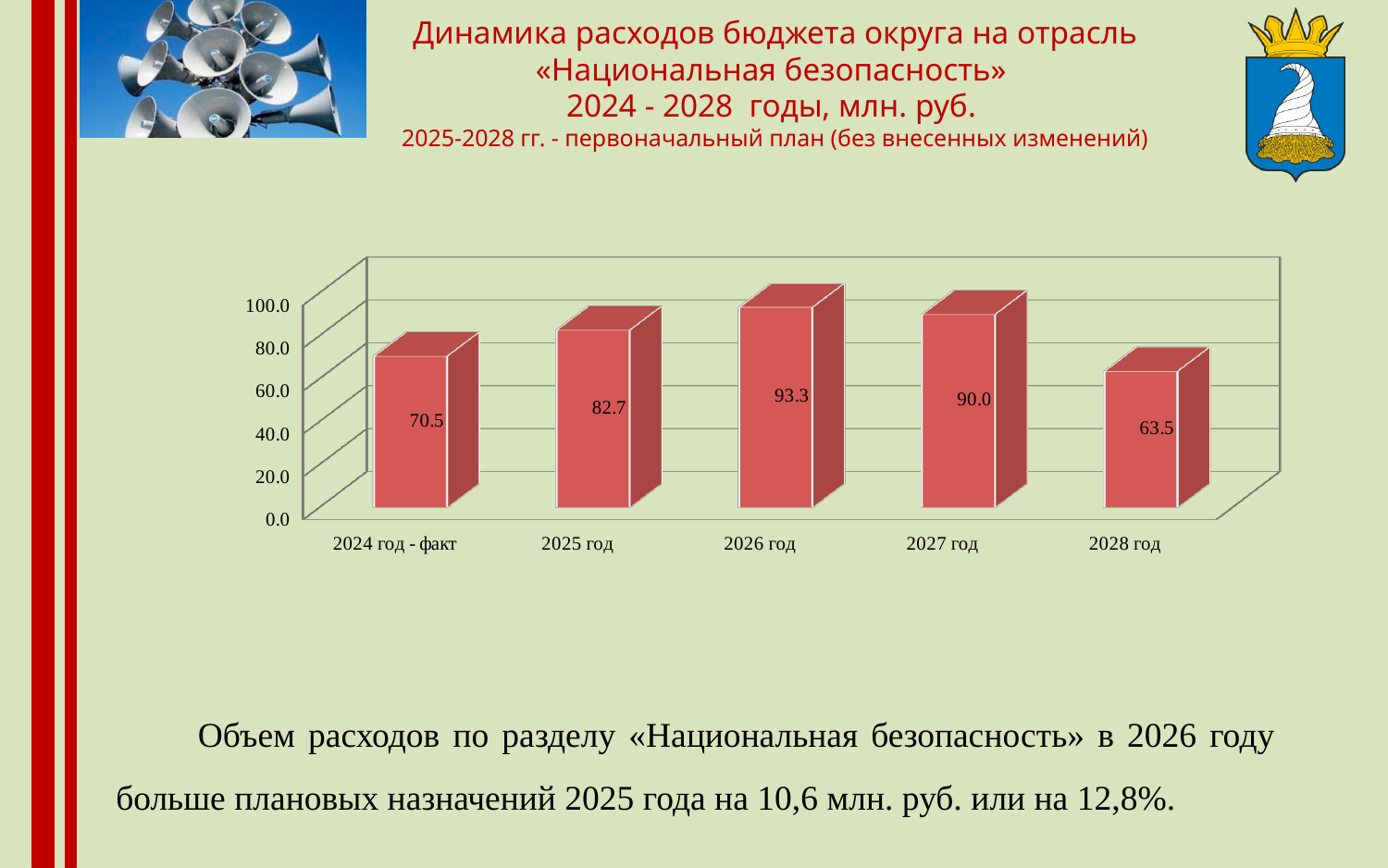
Which year has the lowest value? 2028 год How many bars are shown in the chart? 5 What kind of chart is shown on the slide? bar chart What is the value for 2024 год - факт? 70.5 Is the value for 2024 год - факт greater or less than 80.0? less Which year has the highest value? 2026 год What is the difference between the values for 2027 год and 2028 год? 26.5 What is the unit of measurement stated in the chart title? млн. руб. What is the difference between the values for 2026 год and 2025 год? 10.6 Which is larger, the value for 2025 год or the value for 2027 год? 2027 год What is the value for 2026 год? 93.3 What is the value for 2028 год? 63.5